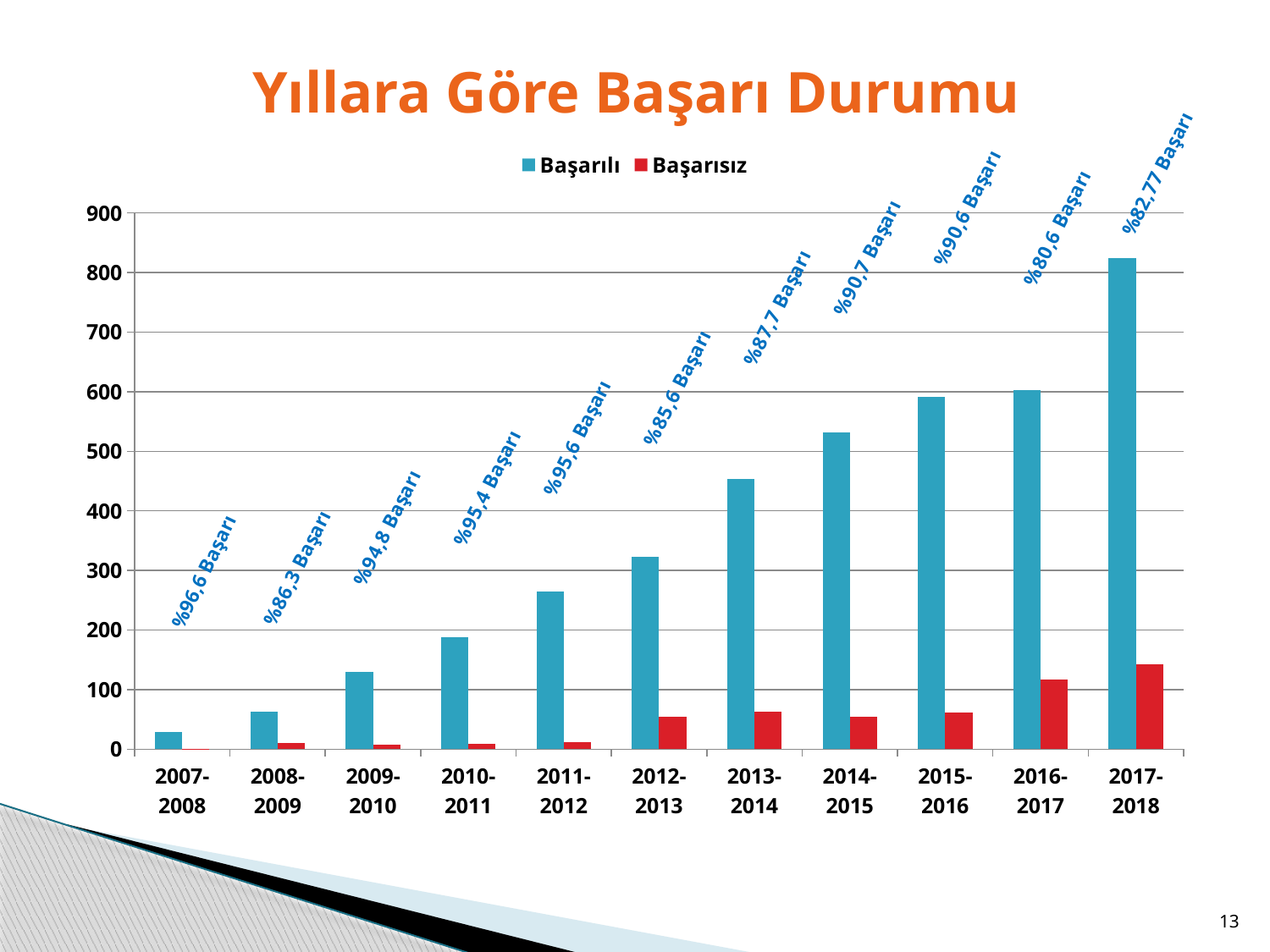
What success percentage label is printed above the 2007-2008 bars? %96,6 Başarı Is the Başarılı value for 2017-2018 greater or less than 800? greater Is the Başarısız value for 2017-2018 greater or less than 100? greater How many series does the legend list? 2 Which year has the highest Başarısız value? 2017-2018 Which year has the lowest Başarılı value? 2007-2008 Do the Başarılı values rise or fall from 2007-2008 to 2017-2018? rise How many academic-year categories are shown on the x axis? 11 What kind of chart is shown on the slide? bar chart Is the Başarılı value for 2013-2014 greater or less than 500? less Which year has the highest Başarılı value? 2017-2018 What is the title of the chart? Yıllara Göre Başarı Durumu